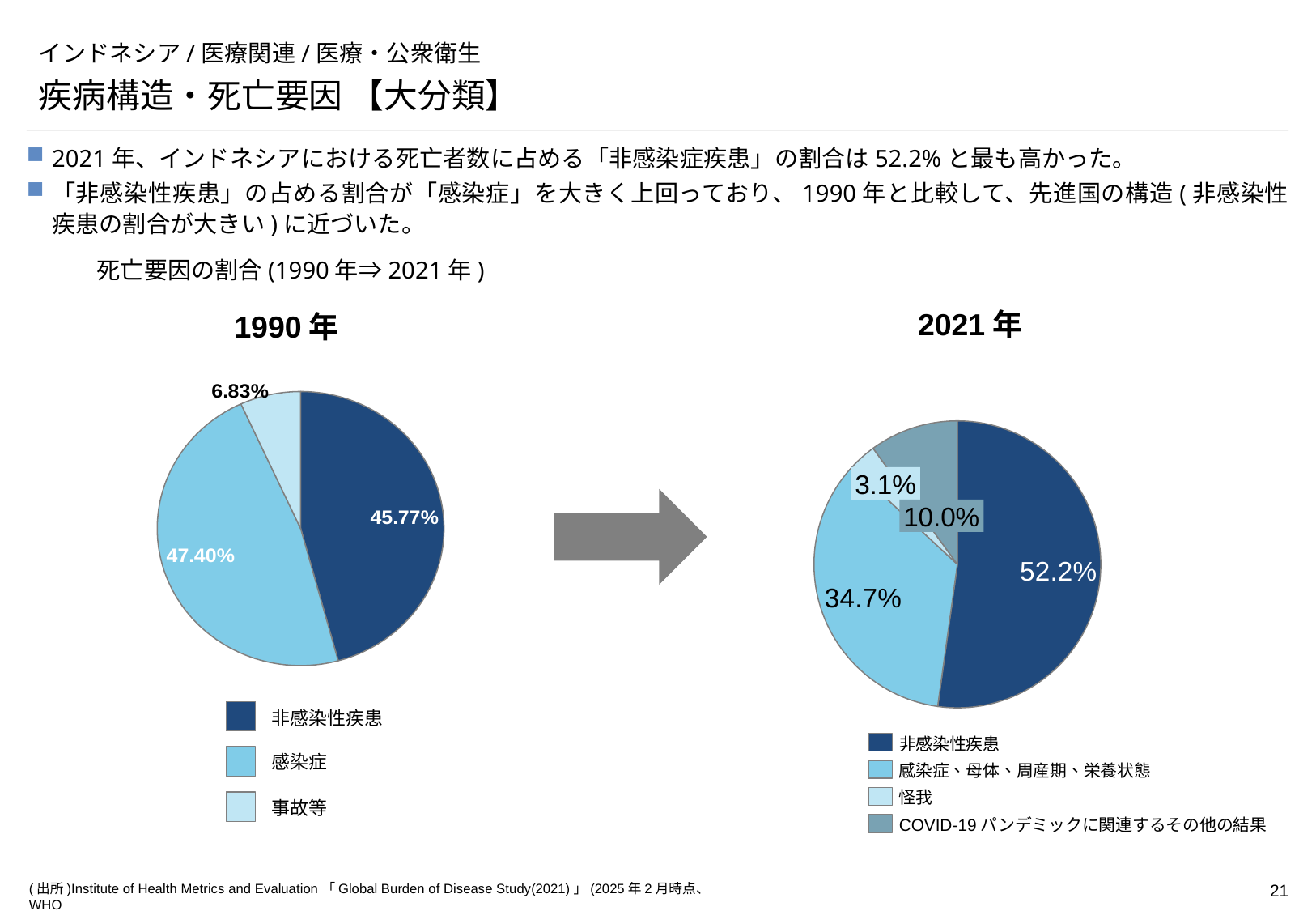
In the 1990 年 pie chart, which category has the largest share? 感染症 How many categories does the legend of the 1990 年 pie chart list? 3 In the 1990 年 pie chart, what share is shown for 事故等? 6.83% In the 2021 年 pie chart, what share is shown for 非感染性疾患? 52.2% In the 2021 年 pie chart, what is the difference between the shares of 非感染性疾患 and 感染症、母体、周産期、栄養状態? 17.5% In the 2021 年 pie chart, what share is shown for 感染症、母体、周産期、栄養状態? 34.7% In the 1990 年 pie chart, what share is shown for 非感染性疾患? 45.77% In the 2021 年 pie chart, what share is shown for COVID-19 パンデミックに関連するその他の結果? 10.0% What type of chart is used for the 1990 年 and 2021 年 data? Pie chart How many categories does the legend of the 2021 年 pie chart list? 4 In the 1990 年 pie chart, what share is shown for 感染症? 47.40% In the 2021 年 pie chart, which category has the smallest share? 怪我